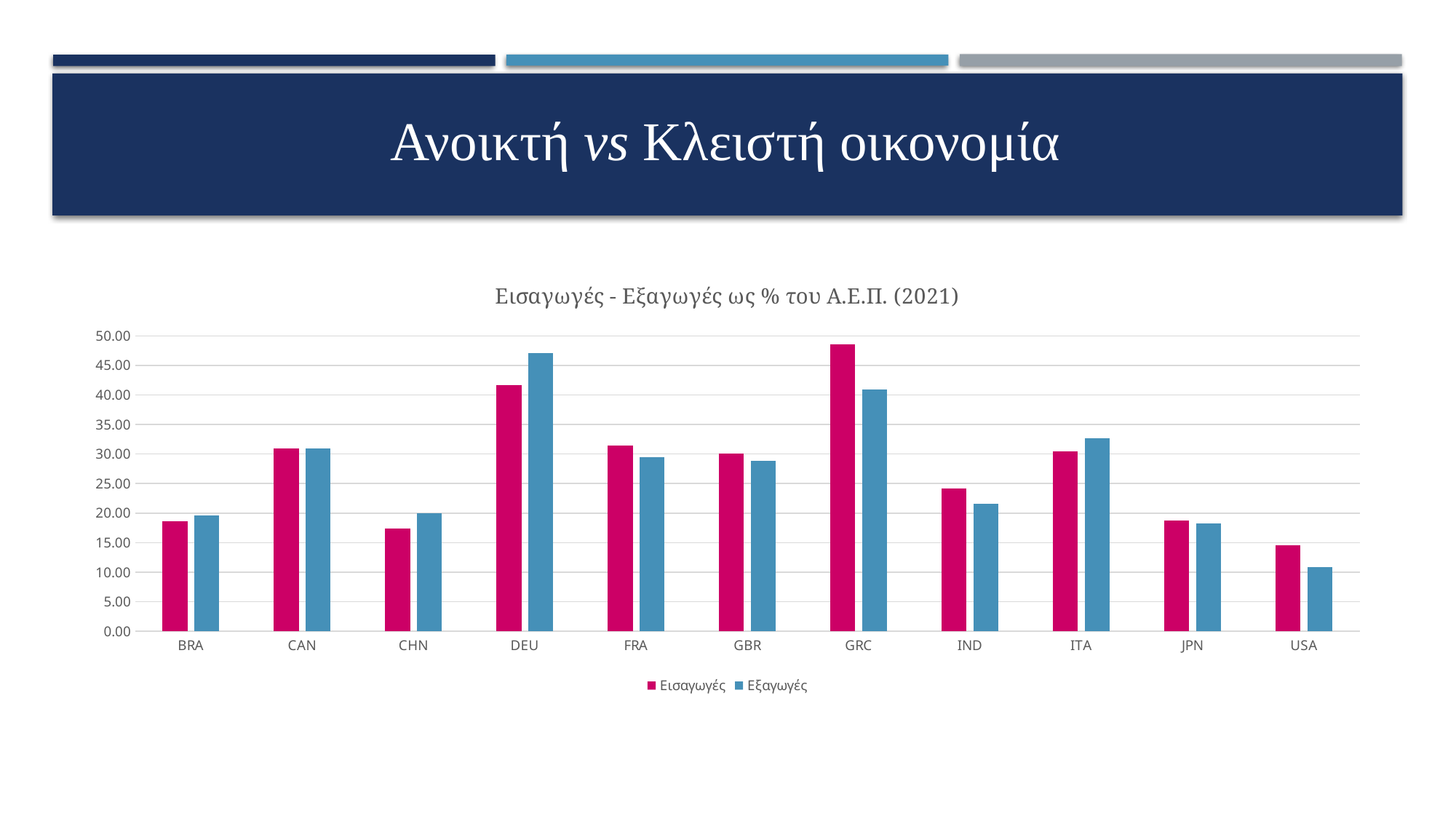
Is the Εισαγωγές value for CHN greater or less than 20.00? less Which country has the lowest value for Εισαγωγές? USA For GRC, which is larger, Εισαγωγές or Εξαγωγές? Εισαγωγές Which country has the highest value for Εξαγωγές? DEU What kind of chart is shown on the slide? bar chart Which country has the highest value for Εισαγωγές? GRC Which country has the lowest value for Εξαγωγές? USA What is the title of the chart? Εισαγωγές - Εξαγωγές ως % του Α.Ε.Π. (2021) How many series does the legend list? 2 How many countries are shown on the x axis? 11 Is the Εξαγωγές value for ITA greater or less than 30.00? greater Is the Εξαγωγές value for DEU greater or less than 45.00? greater